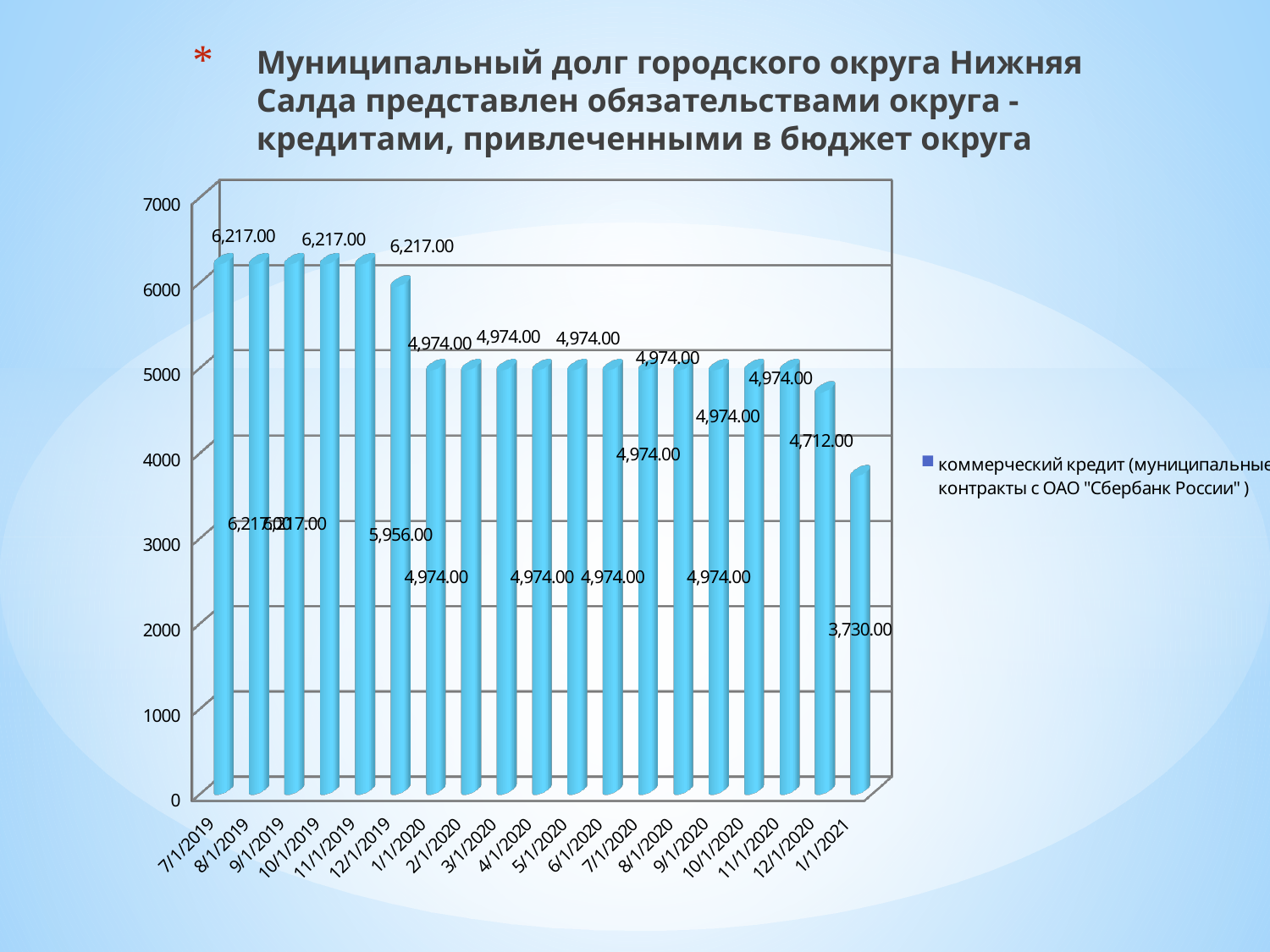
What is the value for 1/1/2021? 3,730.00 What is the value for 7/1/2019? 6,217.00 Do the values rise or fall from 7/1/2019 to 1/1/2021? fall How many dates are shown on the x axis? 19 What is the difference between the values for 7/1/2019 and 1/1/2021? 2,487.00 What is the value for 5/1/2020? 4,974.00 What is the value for 12/1/2020? 4,712.00 Which date has the lowest value? 1/1/2021 Which is larger, the value for 11/1/2019 or the value for 1/1/2020? 11/1/2019 Is the value for 12/1/2020 greater or less than 5000? less What is the value for 12/1/2019? 5,956.00 What is the difference between the values for 12/1/2019 and 12/1/2020? 1,244.00